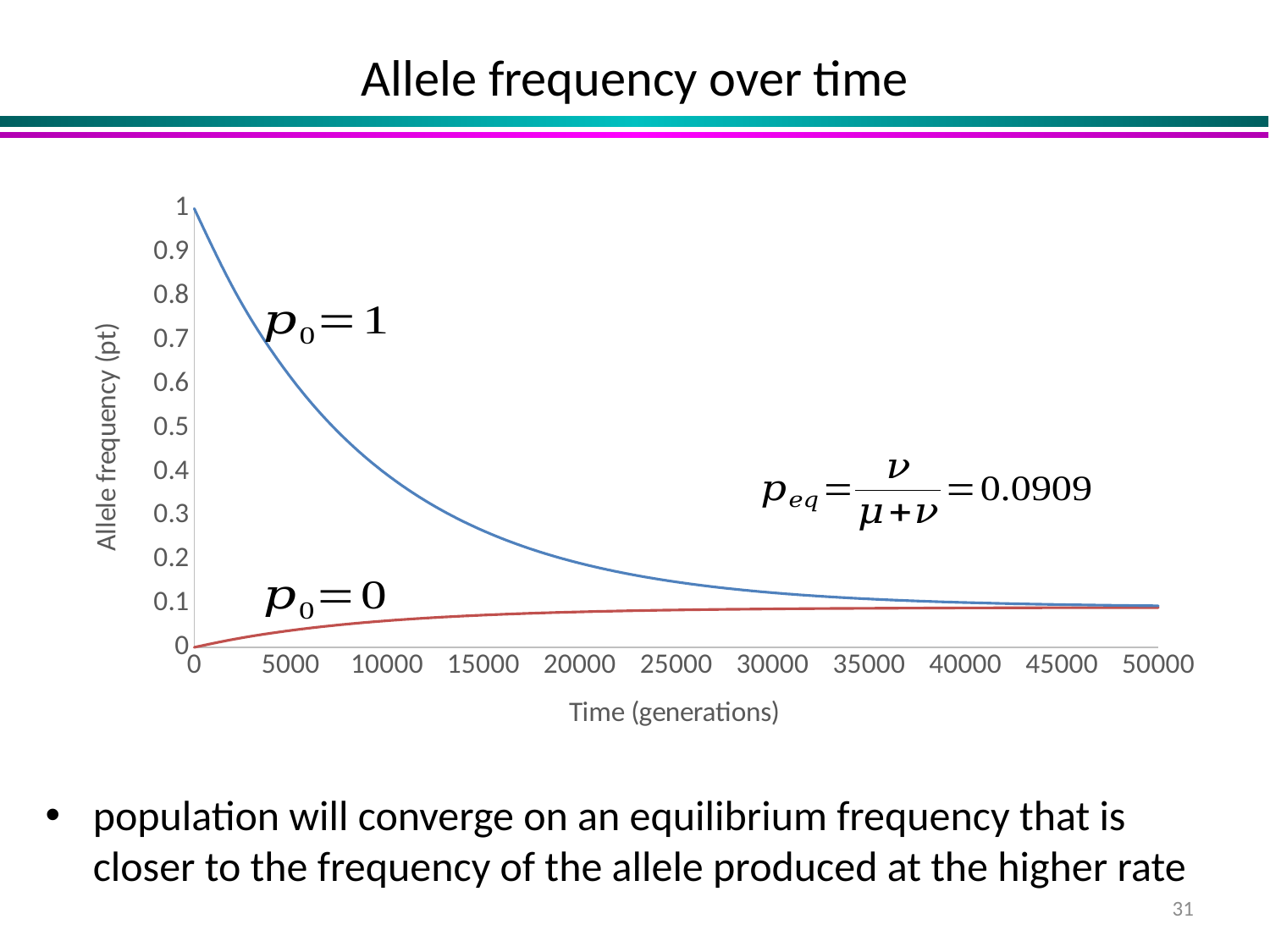
What is the allele frequency of the p0=0 line at time 0? 0 What is the allele frequency of the p0=1 line at time 0? 1 Is the value of the p0=1 line at 5000 generations greater or less than 0.5? greater What kind of chart is shown on the slide? line chart Is the value of the p0=1 line at 20000 generations greater or less than 0.3? less At 5000 generations, which line has the higher allele frequency, p0=1 or p0=0? p0=1 Does the line labelled p0=1 rise or fall as time increases? fall Is the value of the p0=0 line at 10000 generations greater or less than 0.1? less What is the label of the x axis of the chart? Time (generations) How many lines are plotted on the chart? 2 What is the title of the chart? Allele frequency over time Does the line labelled p0=0 rise or fall as time increases? rise